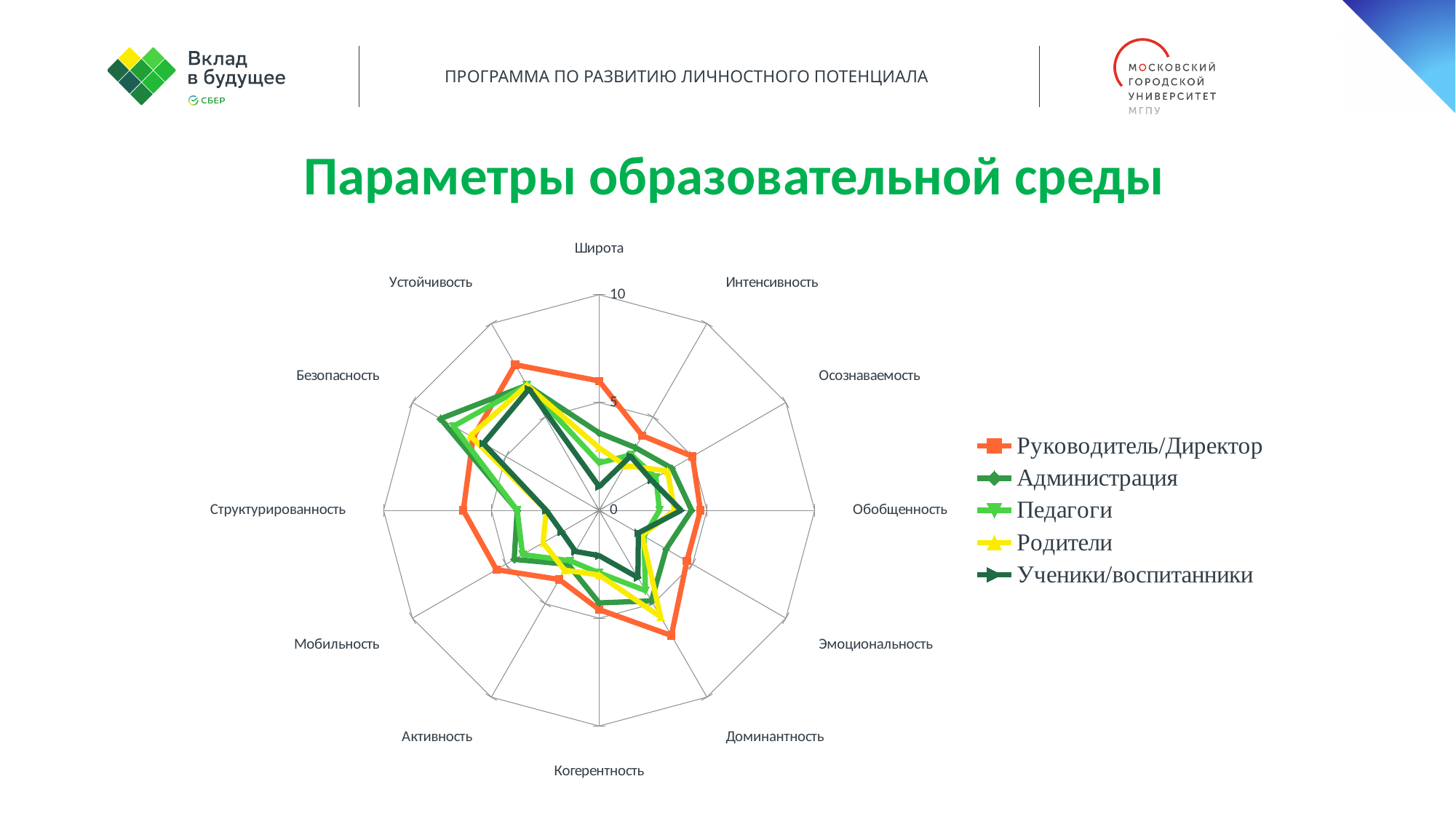
Is the value for Ученики/воспитанники on the Интенсивность axis greater or less than 5? less Is the value for Ученики/воспитанники on the Широта axis greater or less than 5? less How many series does the legend list? 5 What kind of chart is shown on the slide? Radar chart Which series is drawn in orange in the legend? Руководитель/Директор Is the value for Ученики/воспитанники on the Структурированность axis greater or less than 5? less On the Широта axis, which series has the larger value: Руководитель/Директор or Ученики/воспитанники? Руководитель/Директор What is the title of the slide containing the chart? Параметры образовательной среды How many categories (axes) does the radar chart have? 12